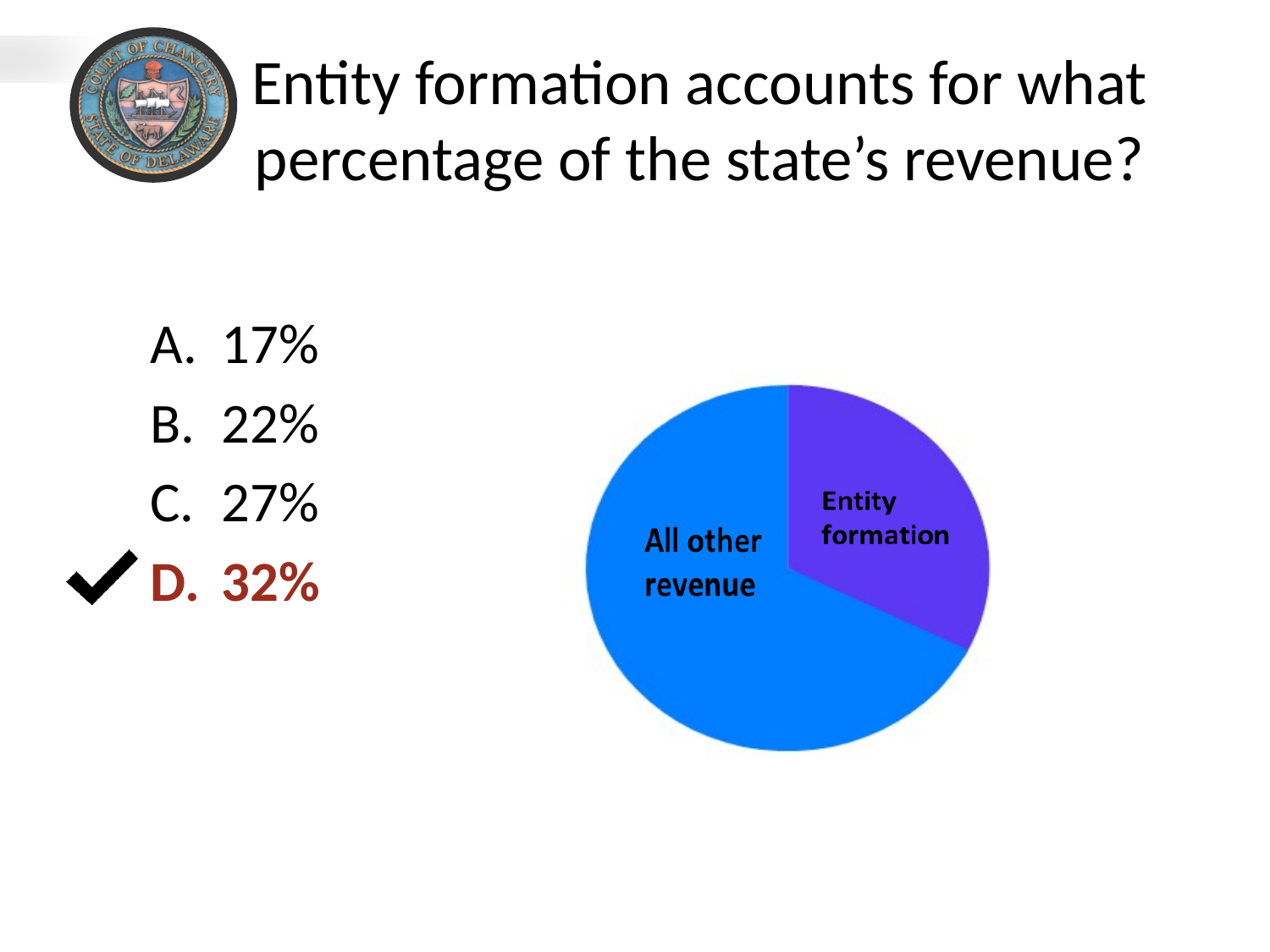
What kind of chart is shown on the slide? pie chart Which slice of the pie chart is the largest? All other revenue According to the slide, what share of the state's revenue does the Entity formation slice represent? 32% How many slices does the pie chart have? 2 What colour is the Entity formation slice in the pie chart? purple What is the label of the blue slice in the pie chart? All other revenue Is the Entity formation slice more or less than half of the pie? less Which is larger in the pie chart, Entity formation or All other revenue? All other revenue Which slice of the pie chart is the smallest? Entity formation